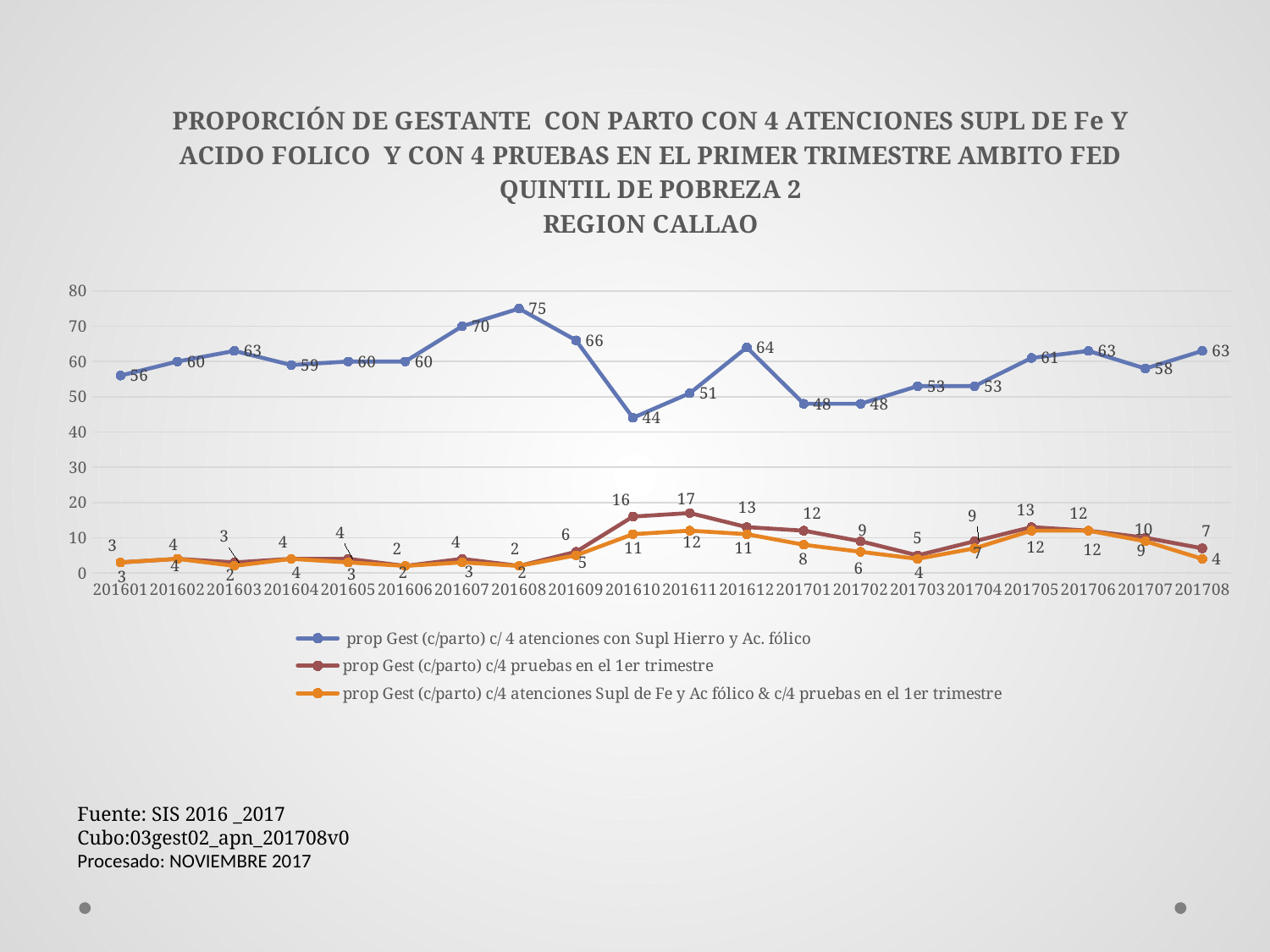
What type of chart is shown on the slide? line chart What is the difference between the 201608 and 201610 values of the series 'prop Gest (c/parto) c/ 4 atenciones con Supl Hierro y Ac. fólico'? 31 What is the value of the series 'prop Gest (c/parto) c/ 4 atenciones con Supl Hierro y Ac. fólico' for 201608? 75 Which region does the chart title refer to? REGION CALLAO In which period does the series 'prop Gest (c/parto) c/4 pruebas en el 1er trimestre' reach its highest value? 201611 How many time periods are plotted along the x axis? 20 What is the value of the series 'prop Gest (c/parto) c/4 pruebas en el 1er trimestre' for 201701? 12 Which is larger for 201612: the value of 'prop Gest (c/parto) c/4 pruebas en el 1er trimestre' or the value of 'prop Gest (c/parto) c/4 atenciones Supl de Fe y Ac fólico & c/4 pruebas en el 1er trimestre'? prop Gest (c/parto) c/4 pruebas en el 1er trimestre Is the value of the series 'prop Gest (c/parto) c/ 4 atenciones con Supl Hierro y Ac. fólico' for 201610 greater or less than 50? less How many series does the legend list? 3 What is the value of the series 'prop Gest (c/parto) c/4 atenciones Supl de Fe y Ac fólico & c/4 pruebas en el 1er trimestre' for 201708? 4 In which period does the series 'prop Gest (c/parto) c/ 4 atenciones con Supl Hierro y Ac. fólico' reach its lowest value? 201610